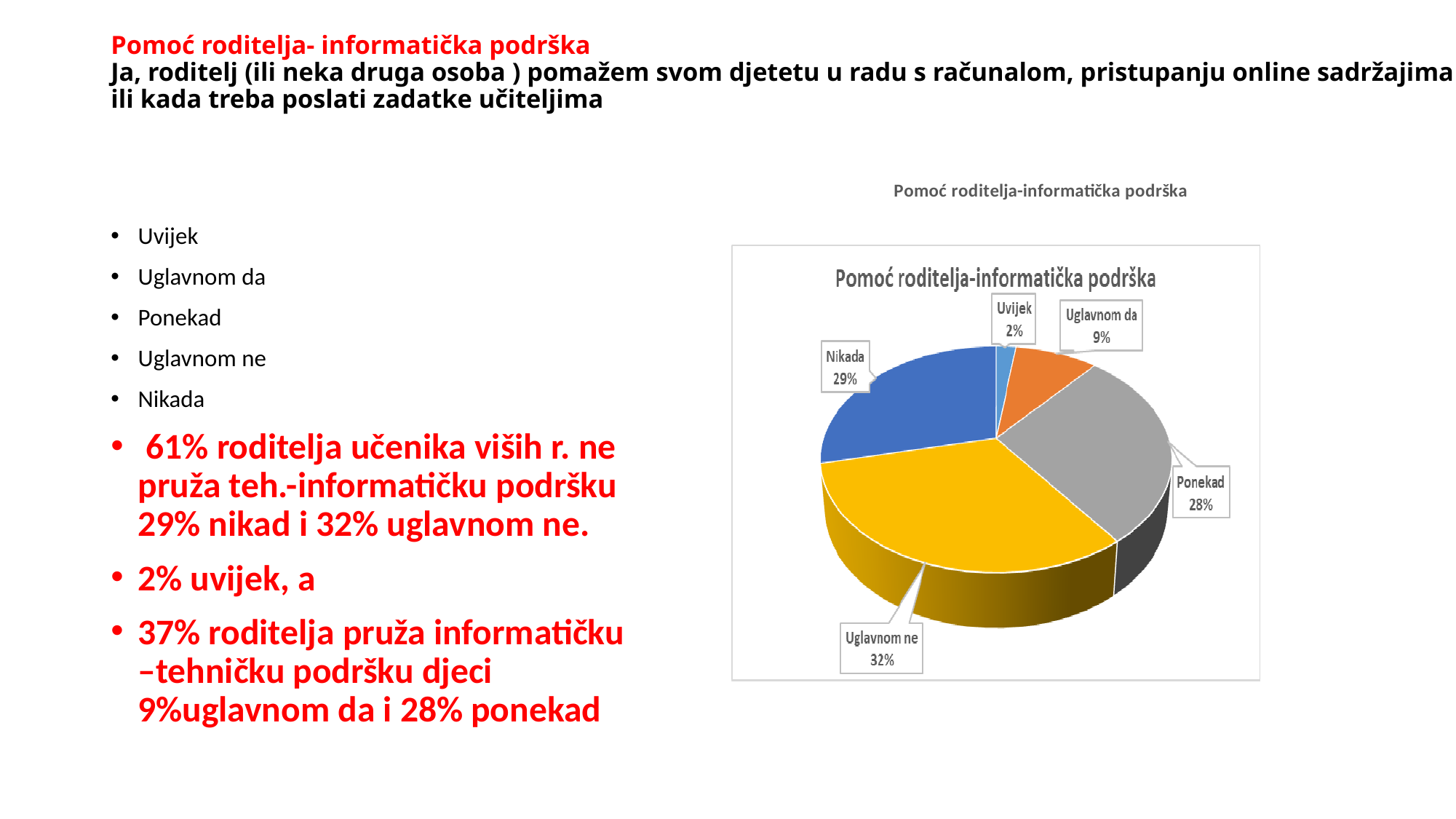
What is the difference in percentage points between the Uglavnom ne and Nikada slices? 3 What percentage is shown for the Ponekad slice? 28% What percentage is shown for the Nikada slice? 29% Which category has the smallest share of the pie? Uvijek What percentage is shown for the Uglavnom da slice? 9% Which is larger, the Ponekad slice or the Uglavnom da slice? Ponekad What is the chart's title? Pomoć roditelja-informatička podrška What percentage is shown for the Uglavnom ne slice? 32% What kind of chart is shown on the slide? pie chart What percentage is shown for the Uvijek slice? 2% How many slices does the pie chart have? 5 Which category has the largest share of the pie? Uglavnom ne